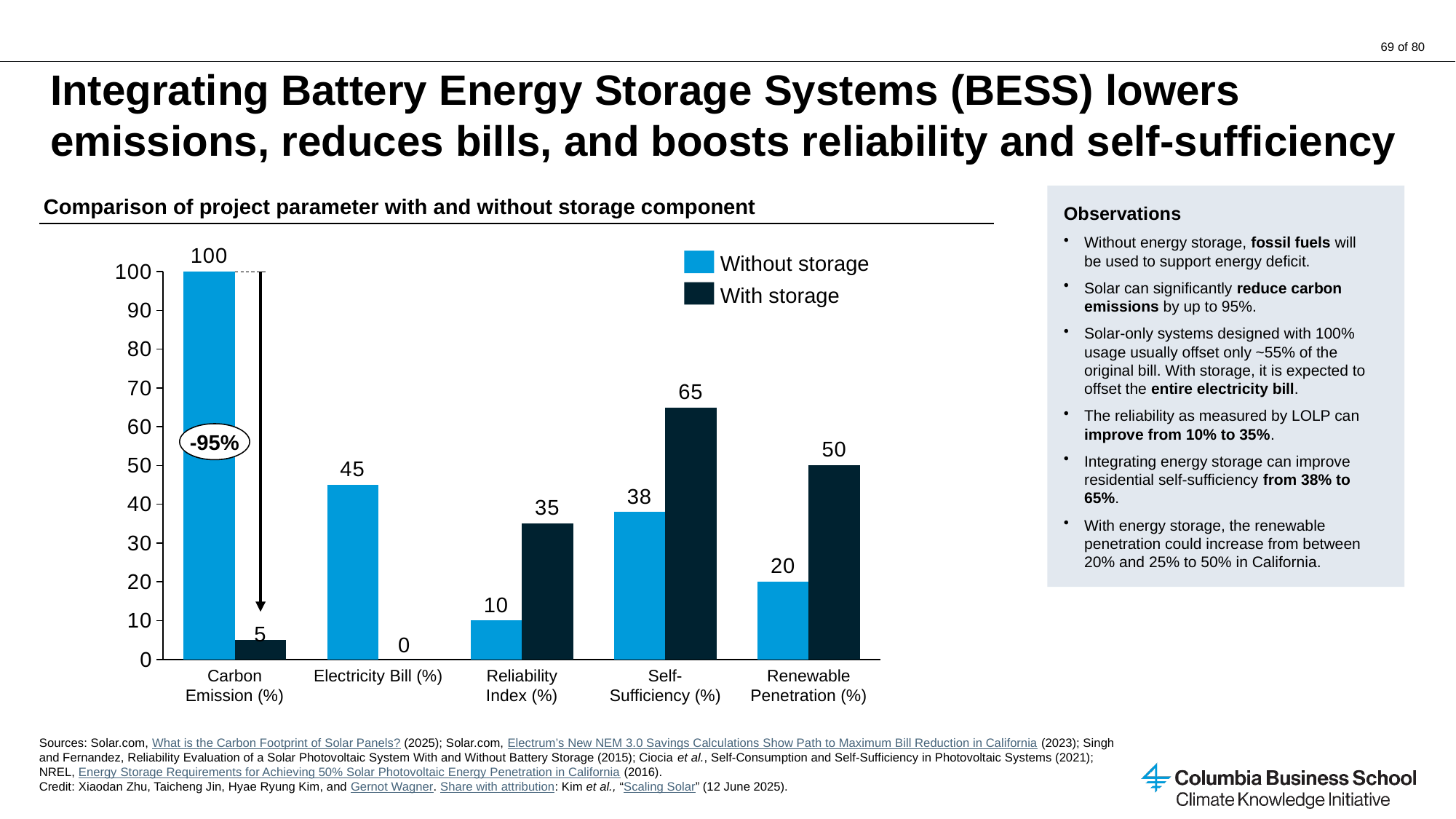
What kind of chart is shown on the slide? Bar chart How many categories are shown on the x axis? 5 For Renewable Penetration (%), which is larger: the value with storage or without storage? With storage What is the value for Self-Sufficiency (%) with storage? 65 What percentage change is shown in the oval annotation next to the Carbon Emission bars? -95% What is the value for Renewable Penetration (%) without storage? 20 What is the difference between the with storage and without storage values for Reliability Index (%)? 25 Which category has the lowest value in the With storage series? Electricity Bill (%) Which category has the highest value in the Without storage series? Carbon Emission (%) How many series does the legend list? 2 What is the value for Carbon Emission (%) without storage? 100 What is the value for Electricity Bill (%) with storage? 0